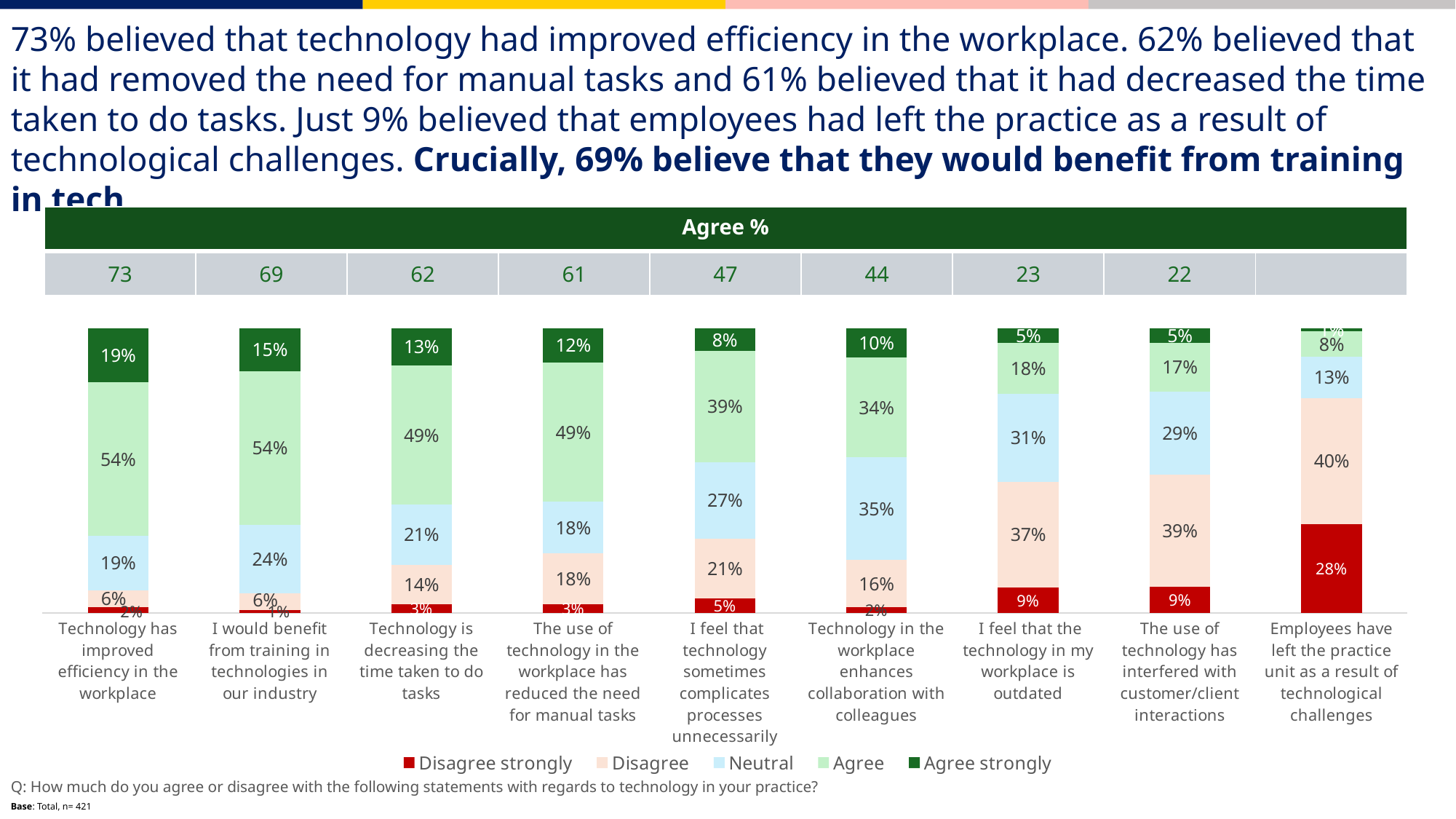
Which statement has the lowest 'Disagree' value? Technology has improved efficiency in the workplace and I would benefit from training in technologies in our industry (both 6%) What is the 'Agree' value for 'Technology has improved efficiency in the workplace'? 54% How many statements (categories) are plotted on the chart? 9 What is the 'Disagree strongly' value for 'Employees have left the practice unit as a result of technological challenges'? 28% What is the difference between the 'Disagree' values for 'Employees have left the practice unit as a result of technological challenges' and 'I feel that the technology in my workplace is outdated'? 3% Which statement has the highest 'Agree strongly' value? Technology has improved efficiency in the workplace How many series does the legend list? 5 What is the 'Agree %' shown in the header row for 'The use of technology in the workplace has reduced the need for manual tasks'? 61 Which colour represents 'Disagree strongly' in the legend? Red What is the 'Neutral' value for 'Technology in the workplace enhances collaboration with colleagues'? 35% What kind of chart is shown on the slide? Stacked bar chart Which is larger: the 'Neutral' value for 'I would benefit from training in technologies in our industry' or the 'Neutral' value for 'Technology is decreasing the time taken to do tasks'? I would benefit from training in technologies in our industry